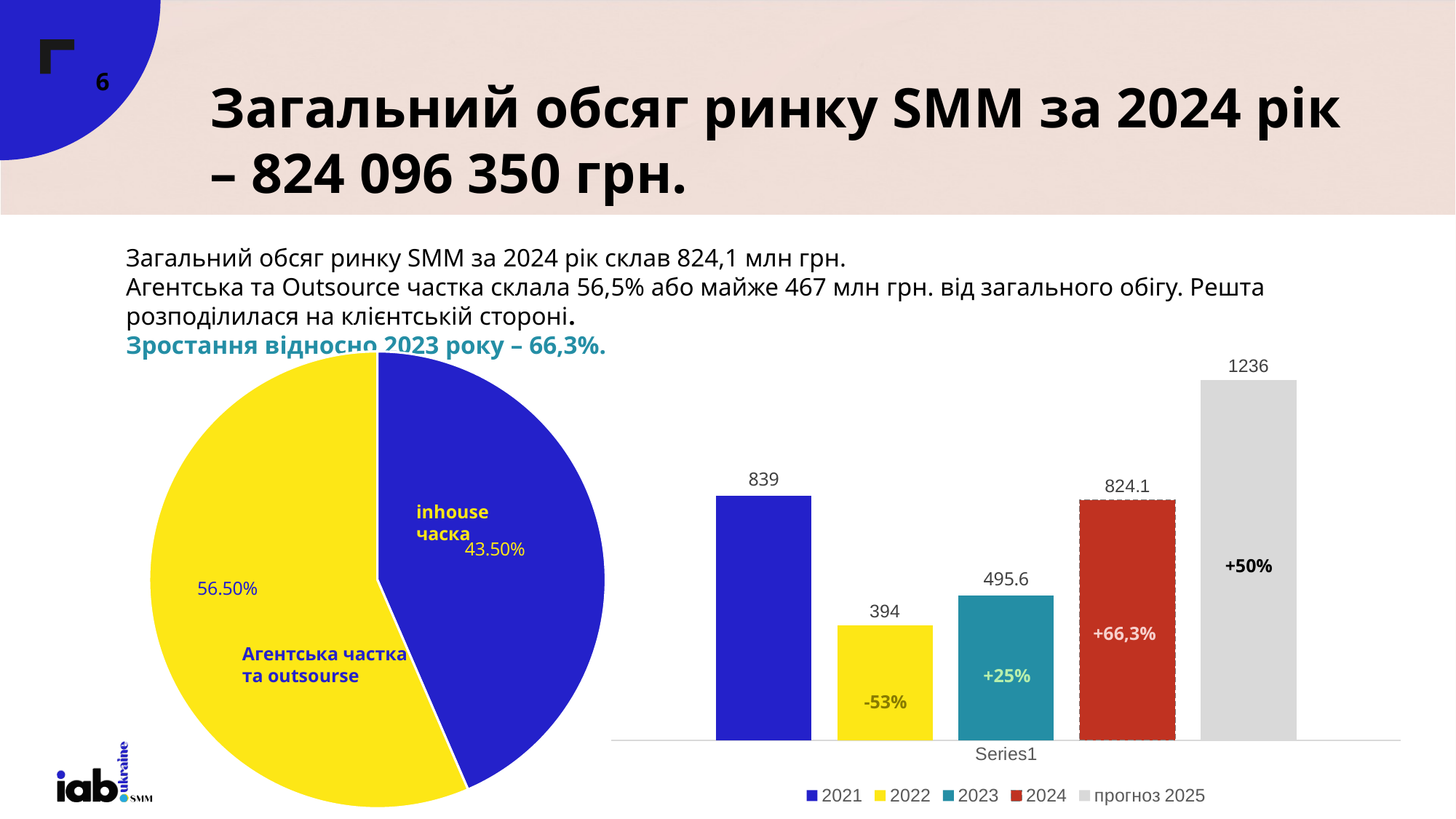
In the bar chart on the right, which series has the highest value? прогноз 2025 In the bar chart on the right, what is the value for прогноз 2025? 1236 In the pie chart on the left, which slice is larger: inhouse частка or Агентська частка та outsourse? Агентська частка та outsourse In the bar chart on the right, what is the difference between the values for 2023 and 2022? 101.6 In the pie chart on the left, what share does the inhouse частка slice have? 43.50% In the bar chart on the right, what percentage change is printed inside the 2022 bar? -53% In the bar chart on the right, what is the value for 2021? 839 In the bar chart on the right, which is larger: the value for 2021 or the value for 2024? 2021 How many series does the legend of the bar chart on the right list? 5 In the bar chart on the right, which year has the lowest value? 2022 What kind of chart is shown on the left of the slide? Pie chart In the bar chart on the right, what is the value for 2024? 824.1